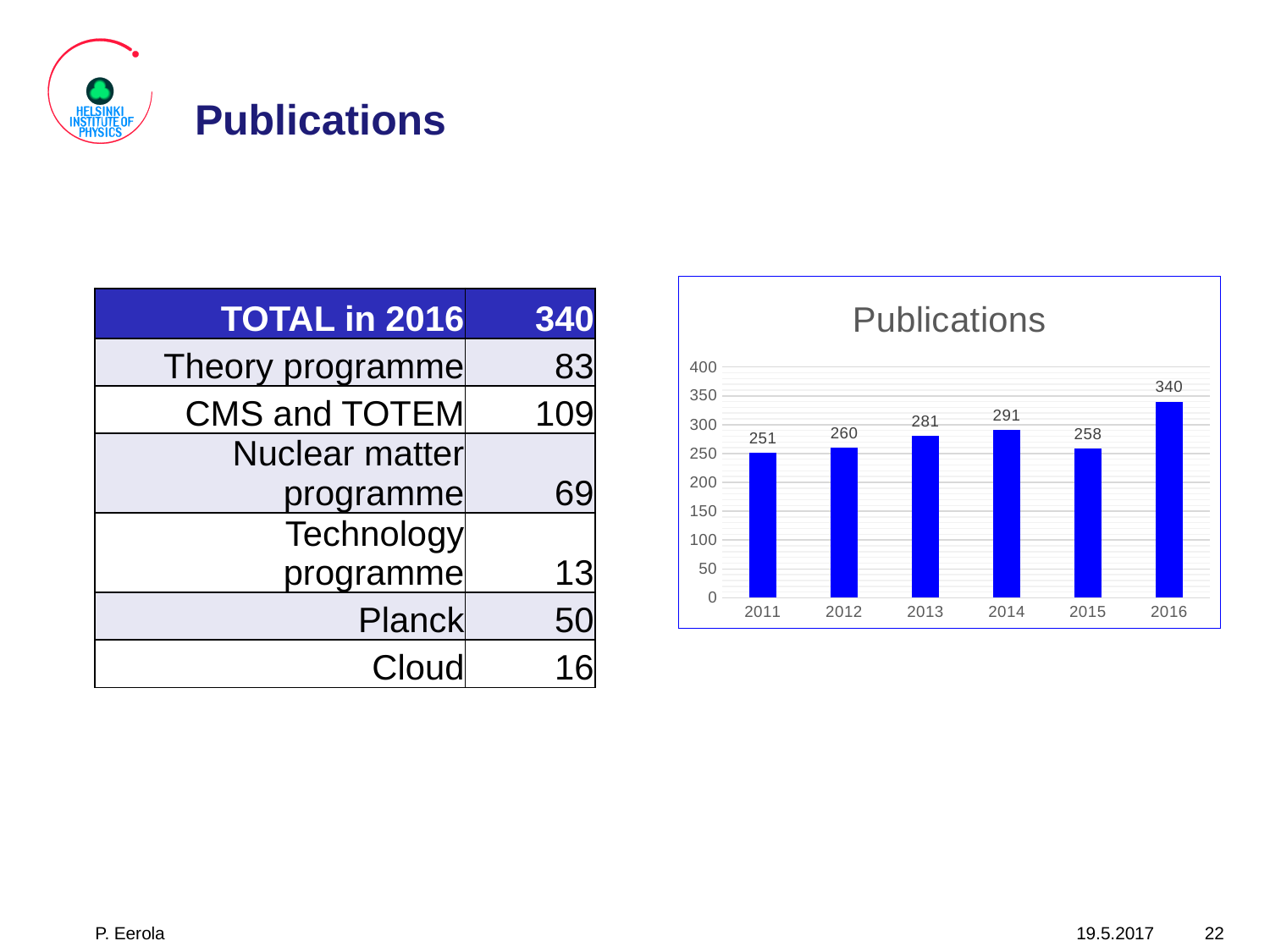
What is the value for 2013 in the Publications chart? 281 What kind of chart is the Publications chart? bar chart What is the difference between the 2014 and 2011 values in the Publications chart? 40 Which year has the highest value in the Publications chart? 2016 What is the value for 2015 in the Publications chart? 258 What is the title of the chart on the slide? Publications Is the value for 2012 in the Publications chart greater or less than 300? less How many years are shown on the x axis of the Publications chart? 6 Does the value in the Publications chart rise or fall from 2014 to 2015? fall Which is larger in the Publications chart, the value for 2014 or the value for 2015? 2014 Which year has the lowest value in the Publications chart? 2011 What is the difference between the 2016 and 2015 values in the Publications chart? 82